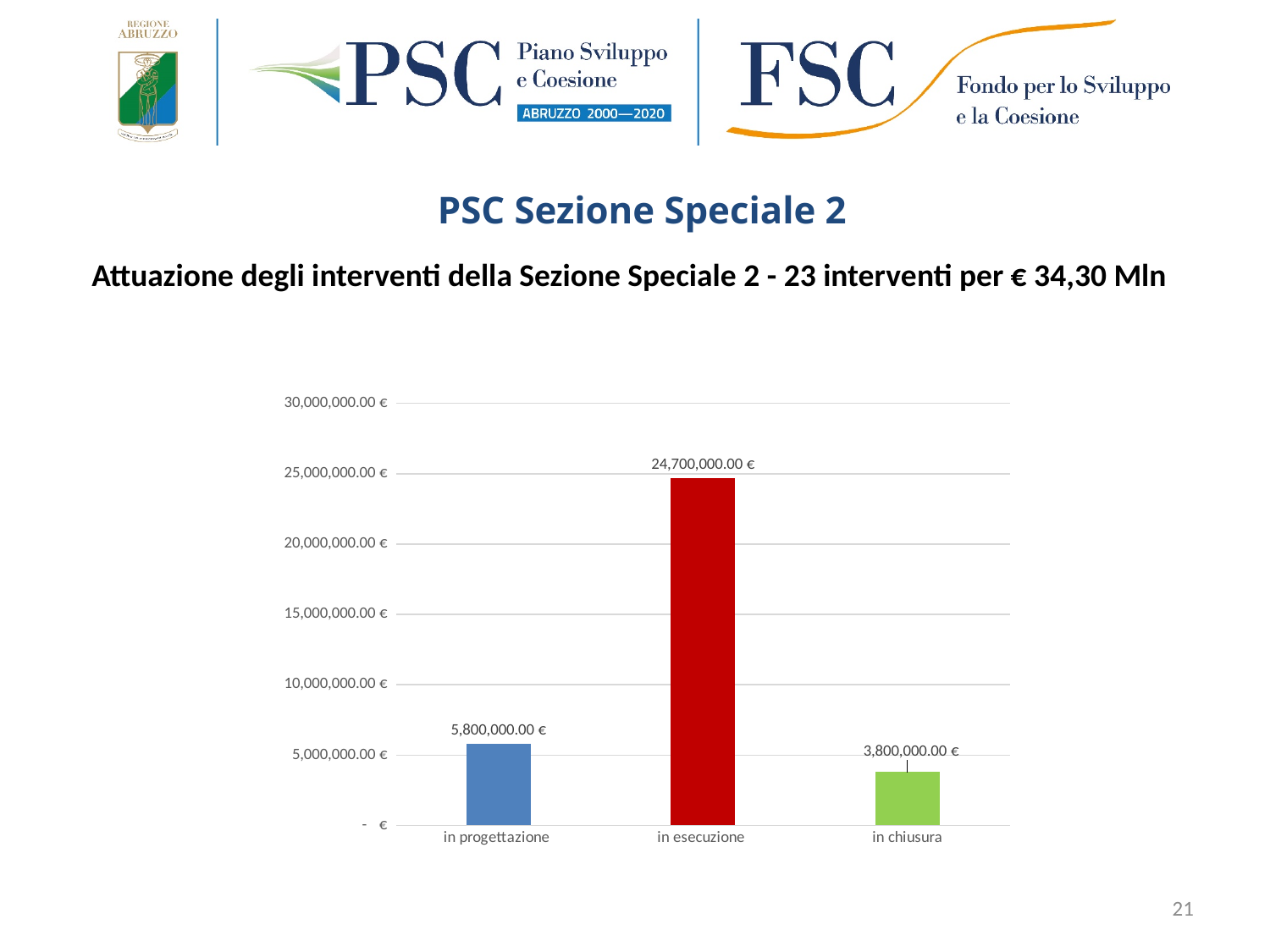
How many categories are shown on the x axis? 3 What is the difference between the values for "in progettazione" and "in chiusura"? 2,000,000.00 € What is the value for "in progettazione"? 5,800,000.00 € What colour is the bar for "in esecuzione"? red Which category has the highest value? in esecuzione Which is larger, the value for "in progettazione" or the value for "in chiusura"? in progettazione What is the value for "in esecuzione"? 24,700,000.00 € What kind of chart is shown on the slide? bar chart What is the value for "in chiusura"? 3,800,000.00 € Is the value for "in esecuzione" greater or less than 20,000,000.00 €? greater Which category has the lowest value? in chiusura What is the difference between the values for "in esecuzione" and "in progettazione"? 18,900,000.00 €